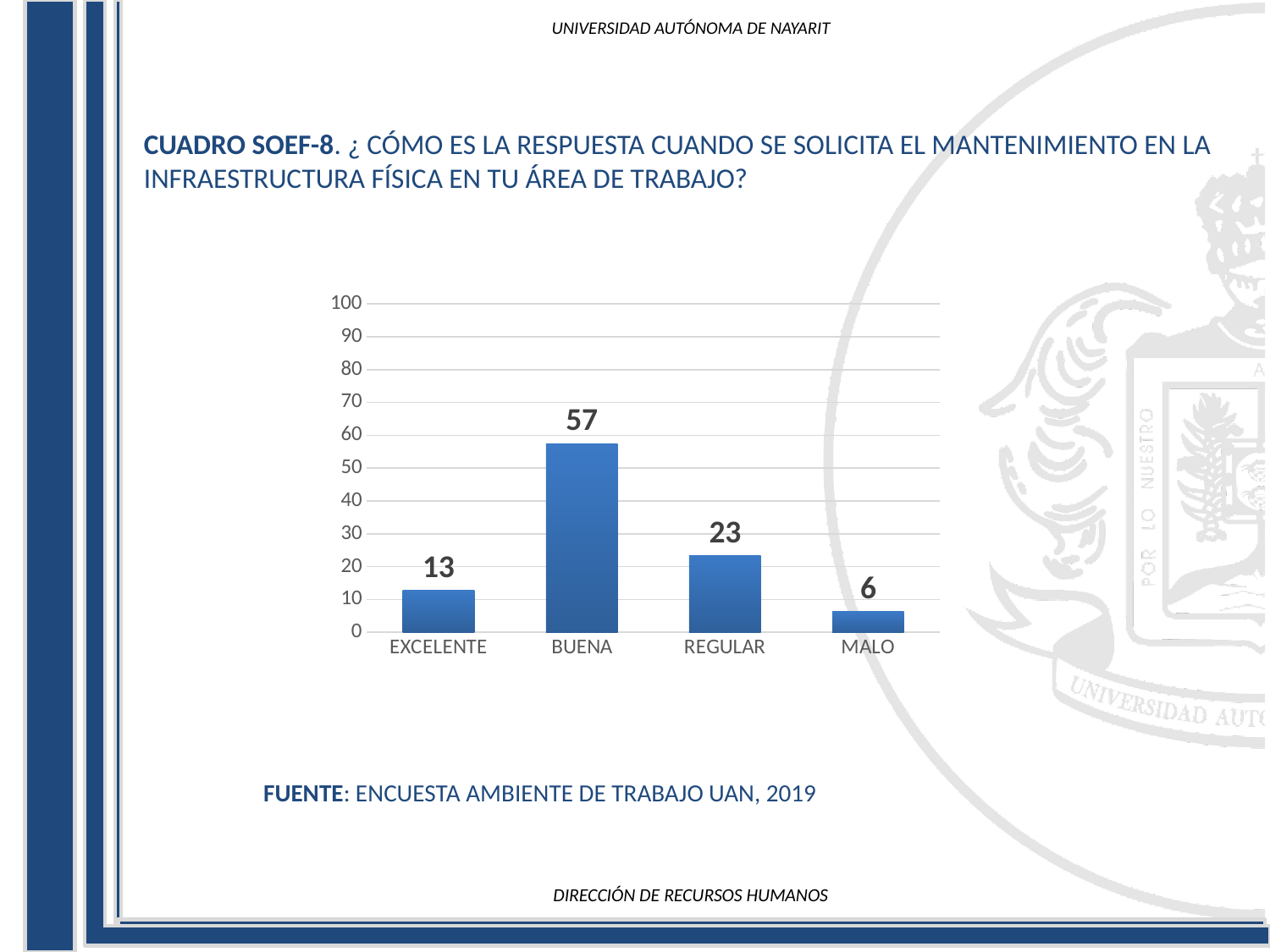
Which is larger, the value for EXCELENTE or the value for REGULAR? REGULAR Is the value for BUENA greater or less than 50? greater What is the value for REGULAR? 23 How many categories are shown on the x axis? 4 What is the difference between the values for EXCELENTE and MALO? 7 What is the value for MALO? 6 What is the difference between the values for BUENA and REGULAR? 34 Which category has the lowest value? MALO Which category has the highest value? BUENA What kind of chart is shown on the slide? bar chart What is the value for BUENA? 57 What is the value for EXCELENTE? 13